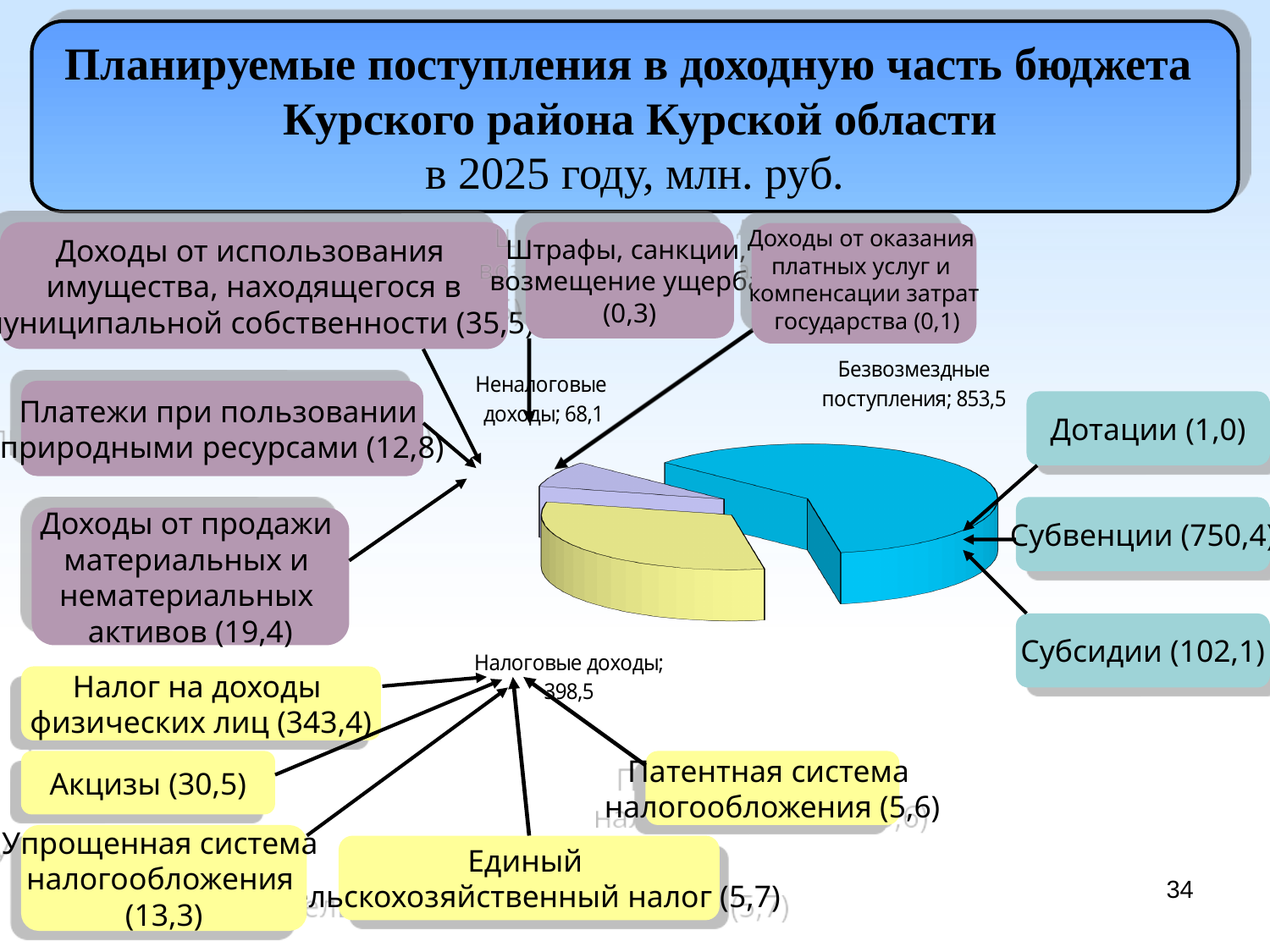
How many slices does the pie chart have? 3 Which slice of the pie chart has the highest value? Безвозмездные поступления Which is larger: Налоговые доходы or Неналоговые доходы? Налоговые доходы What is the value for Налоговые доходы in the pie chart? 398,5 What kind of chart is shown on the slide? pie chart What is the value for Неналоговые доходы in the pie chart? 68,1 What is the difference between the values for Безвозмездные поступления and Налоговые доходы? 455,0 What is the difference between the values for Налоговые доходы and Неналоговые доходы? 330,4 Which slice of the pie chart has the lowest value? Неналоговые доходы What colour is the Безвозмездные поступления slice in the pie chart? blue In what units are the values on the slide expressed, according to the title? млн. руб. What is the value for Безвозмездные поступления in the pie chart? 853,5